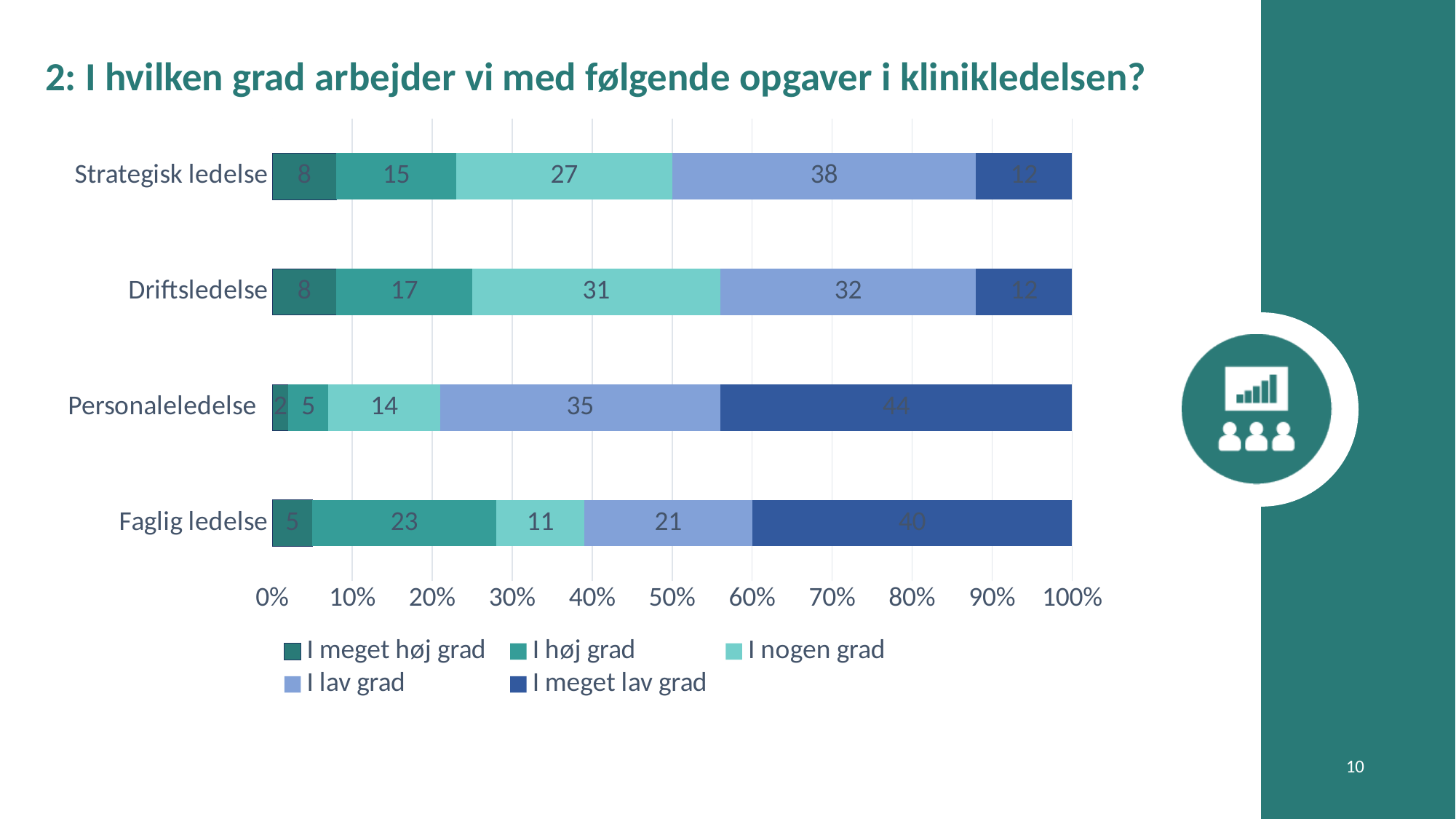
What is the title of the chart? 2: I hvilken grad arbejder vi med følgende opgaver i klinikledelsen? What is the value of 'I nogen grad' for Driftsledelse? 31 Which category has the highest value for 'I meget lav grad'? Personaleledelse What is the value of 'I høj grad' for Faglig ledelse? 23 What kind of chart is shown on the slide? Stacked bar chart What is the value of 'I meget lav grad' for Personaleledelse? 44 Which category has the lowest value for 'I meget høj grad'? Personaleledelse What is the difference between the 'I meget lav grad' values for Personaleledelse and Faglig ledelse? 4 How many categories are plotted on the chart? 4 Which is larger: the 'I nogen grad' value for Strategisk ledelse or for Faglig ledelse? Strategisk ledelse How many series does the legend list? 5 What is the value of 'I lav grad' for Strategisk ledelse? 38